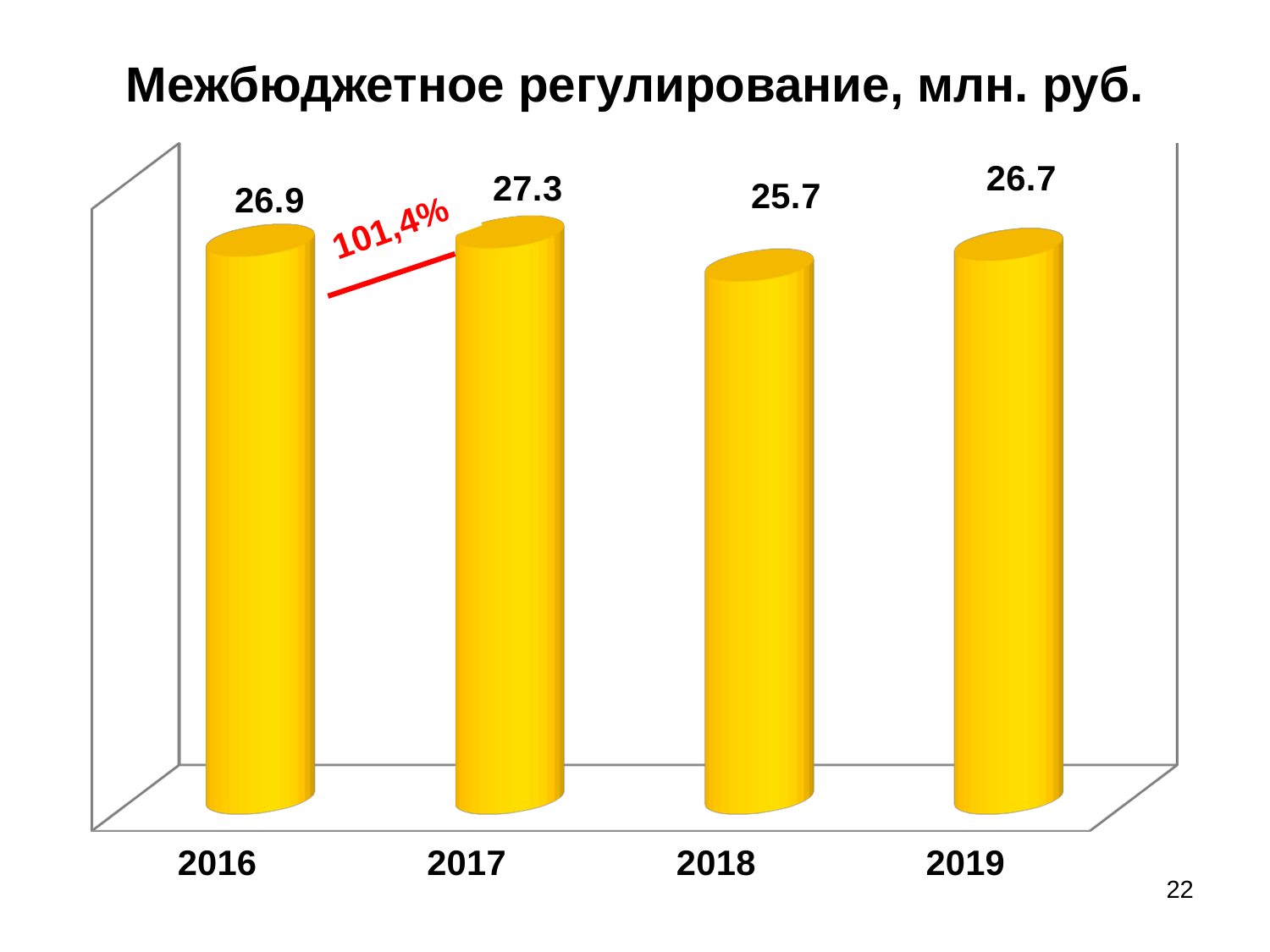
Which year has the lowest value? 2018 What is the difference between the values for 2017 and 2018? 1.6 What kind of chart is this? bar chart Which is larger, the value for 2016 or the value for 2018? 2016 What percentage is written in red between the 2016 and 2017 bars? 101,4% What is the value for 2016? 26.9 What is the difference between the values for 2016 and 2019? 0.2 How many years are shown on the chart? 4 What is the value for 2017? 27.3 What is the value for 2019? 26.7 What is the value for 2018? 25.7 Which year has the highest value? 2017